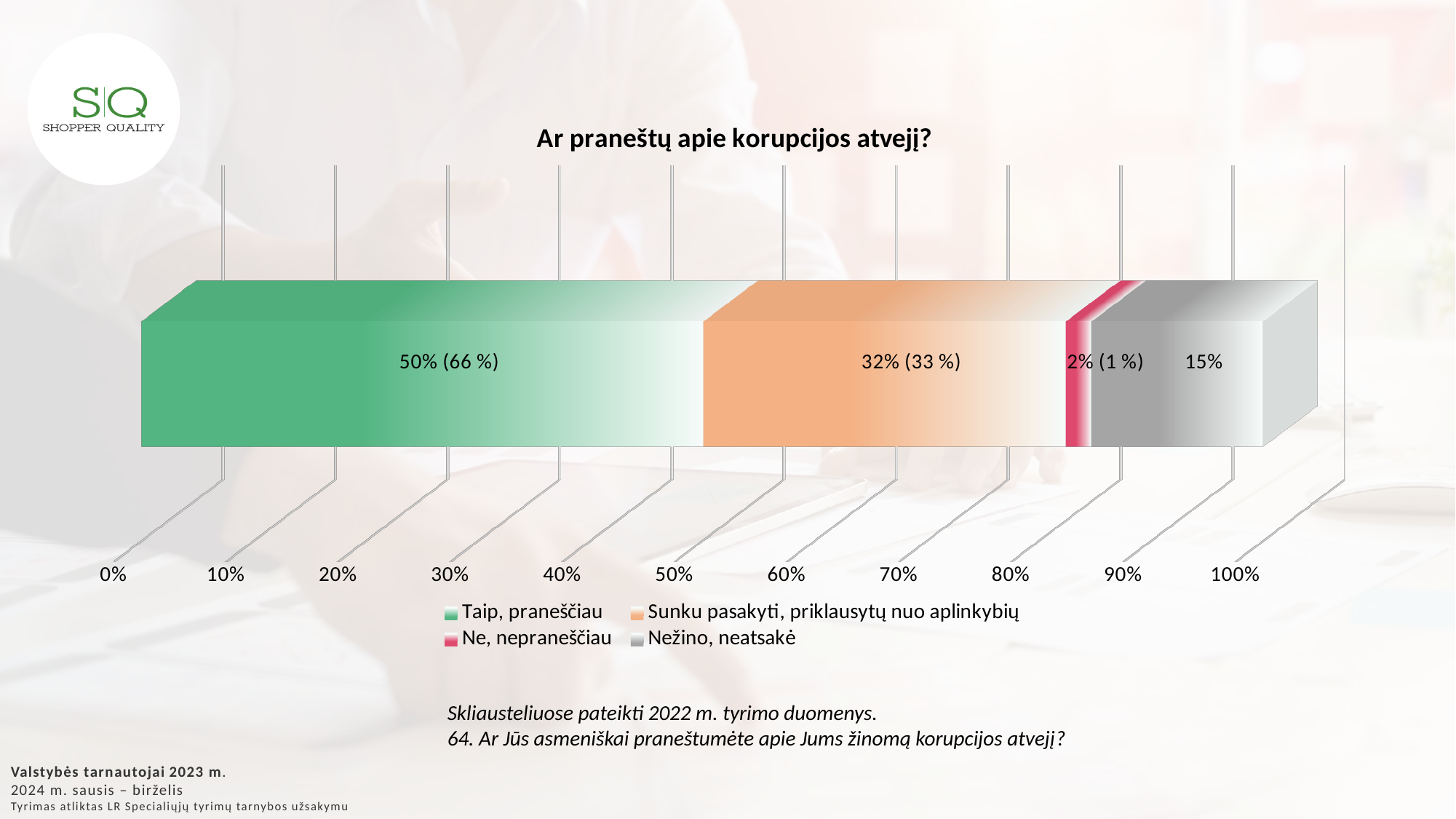
What is the title of the chart? Ar praneštų apie korupcijos atvejį? What percentage of respondents answered "Sunku pasakyti, priklausytų nuo aplinkybių" in 2023? 32% Which answer category has the largest share in 2023? Taip, praneščiau What is the difference between the 2023 shares of "Taip, praneščiau" and "Sunku pasakyti, priklausytų nuo aplinkybių"? 18% What percentage of respondents answered "Taip, praneščiau" in 2023? 50% Which is larger in 2023: the share for "Nežino, neatsakė" or the share for "Ne, nepraneščiau"? Nežino, neatsakė What was the 2022 value (shown in parentheses) for "Taip, praneščiau"? 66 % How many answer categories does the legend list? 4 What type of chart is shown on the slide? Stacked bar chart What percentage of respondents fall under "Nežino, neatsakė"? 15% What percentage of respondents answered "Ne, nepraneščiau" in 2023? 2% Which answer category has the smallest share in 2023? Ne, nepraneščiau